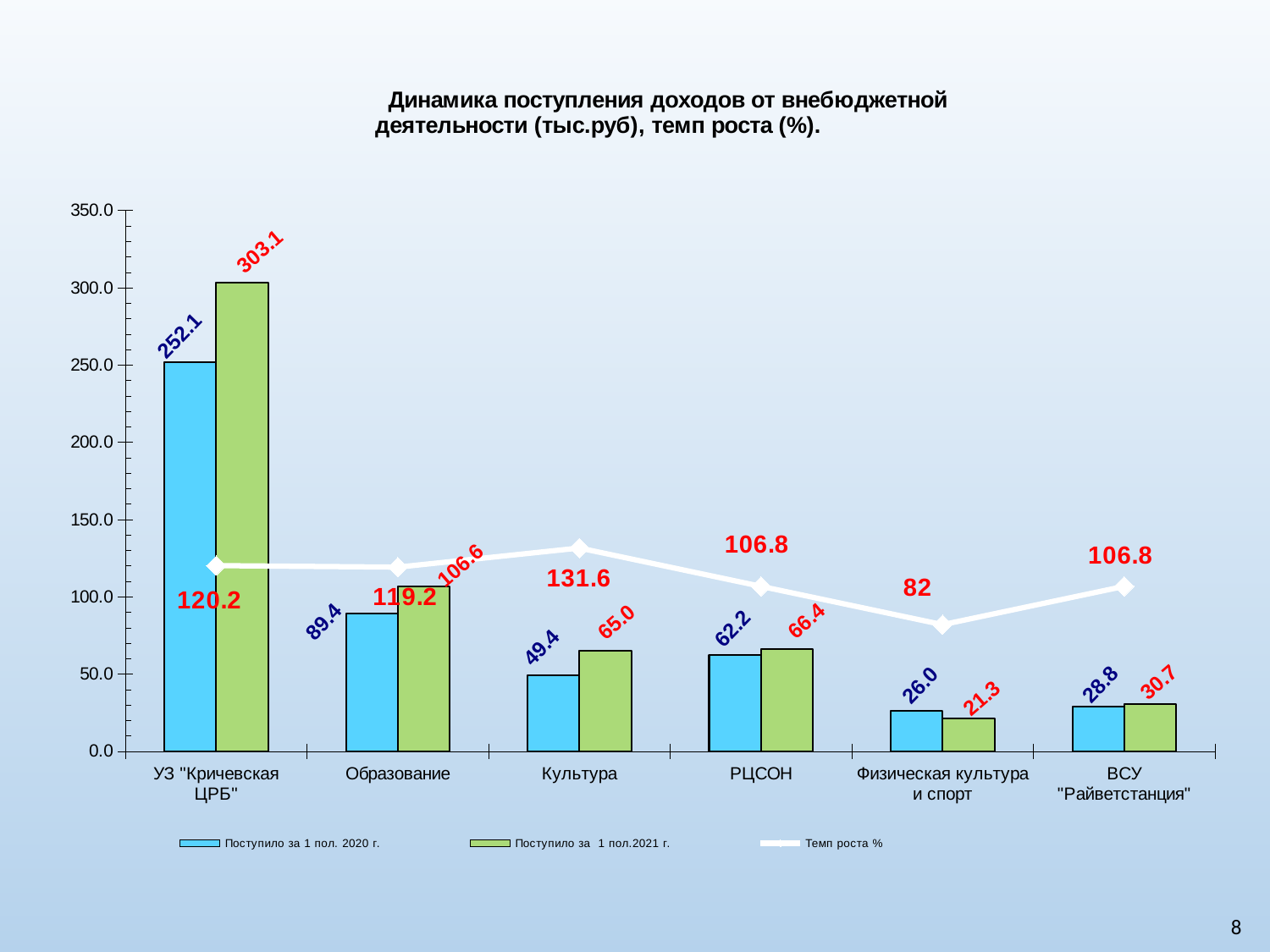
What kind of chart is this? Combined bar and line chart What is the value of "Поступило за 1 пол. 2020 г." for УЗ "Кричевская ЦРБ"? 252.1 Which category has the lowest value for "Поступило за 1 пол. 2020 г."? Физическая культура и спорт How many categories are shown on the x axis? 6 For Физическая культура и спорт, which is larger: the 2020 value or the 2021 value? 2020 value (26.0) Which category has the highest "Темп роста %" value? Культура What is the value of "Поступило за 1 пол.2021 г." for Культура? 65.0 What is the "Темп роста %" value for Физическая культура и спорт? 82 What is the "Темп роста %" value for РЦСОН? 106.8 How many series does the legend list? 3 Which category has the highest value for "Поступило за 1 пол.2021 г."? УЗ "Кричевская ЦРБ" What is the difference between the 2021 and 2020 values for УЗ "Кричевская ЦРБ"? 51.0